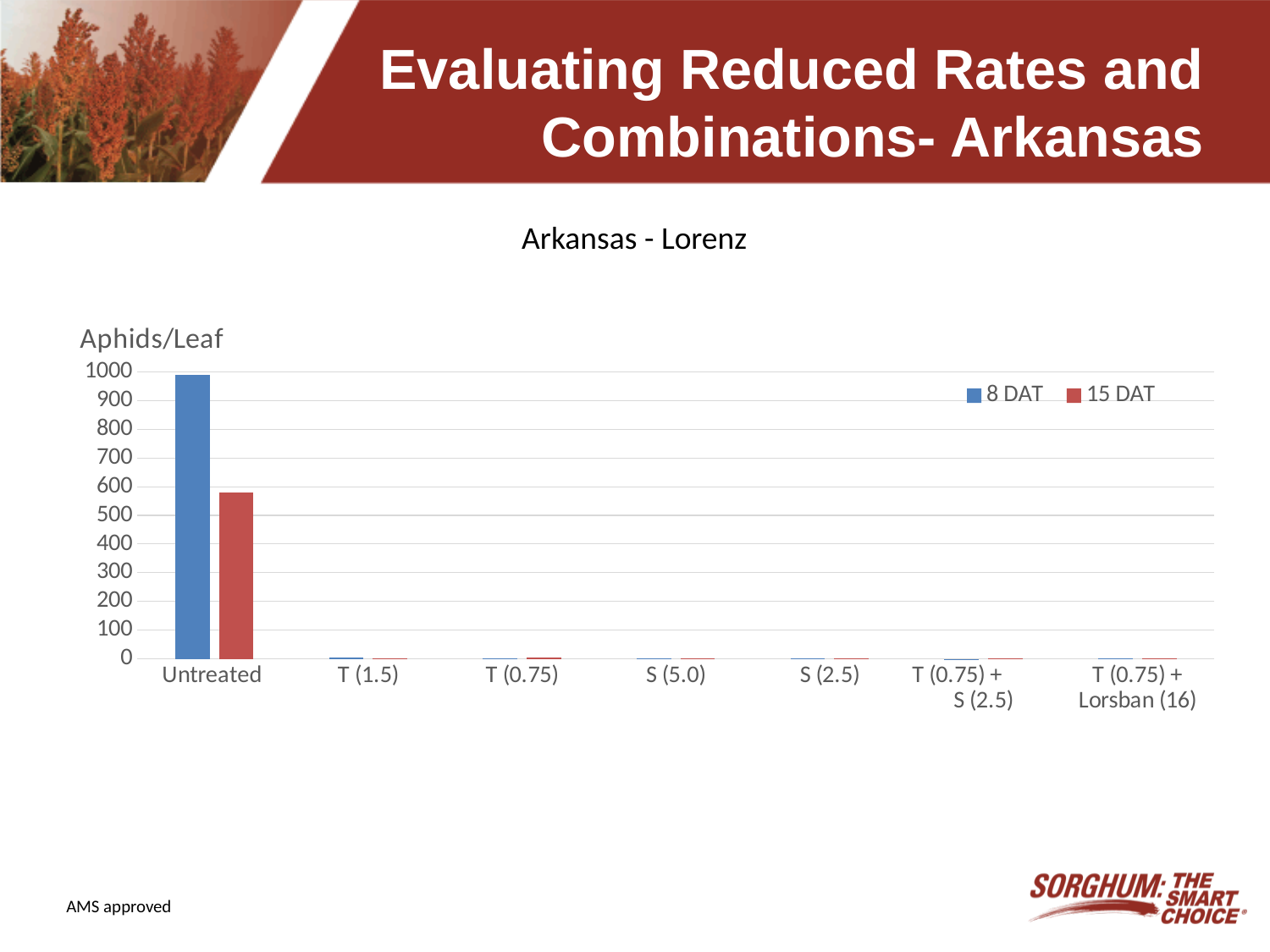
Which category has the highest 15 DAT value? Untreated For the Untreated category, which is larger: the 8 DAT value or the 15 DAT value? 8 DAT Is the 8 DAT value for Untreated greater or less than 900? greater How many series does the legend list? 2 Which category has the highest 8 DAT value? Untreated Is the 15 DAT value for Untreated greater or less than 500? greater What kind of chart is shown on the slide? bar chart Is the 8 DAT value for T (1.5) greater or less than 100? less How many treatment categories are shown on the x axis? 7 What is the title of the chart? Aphids/Leaf